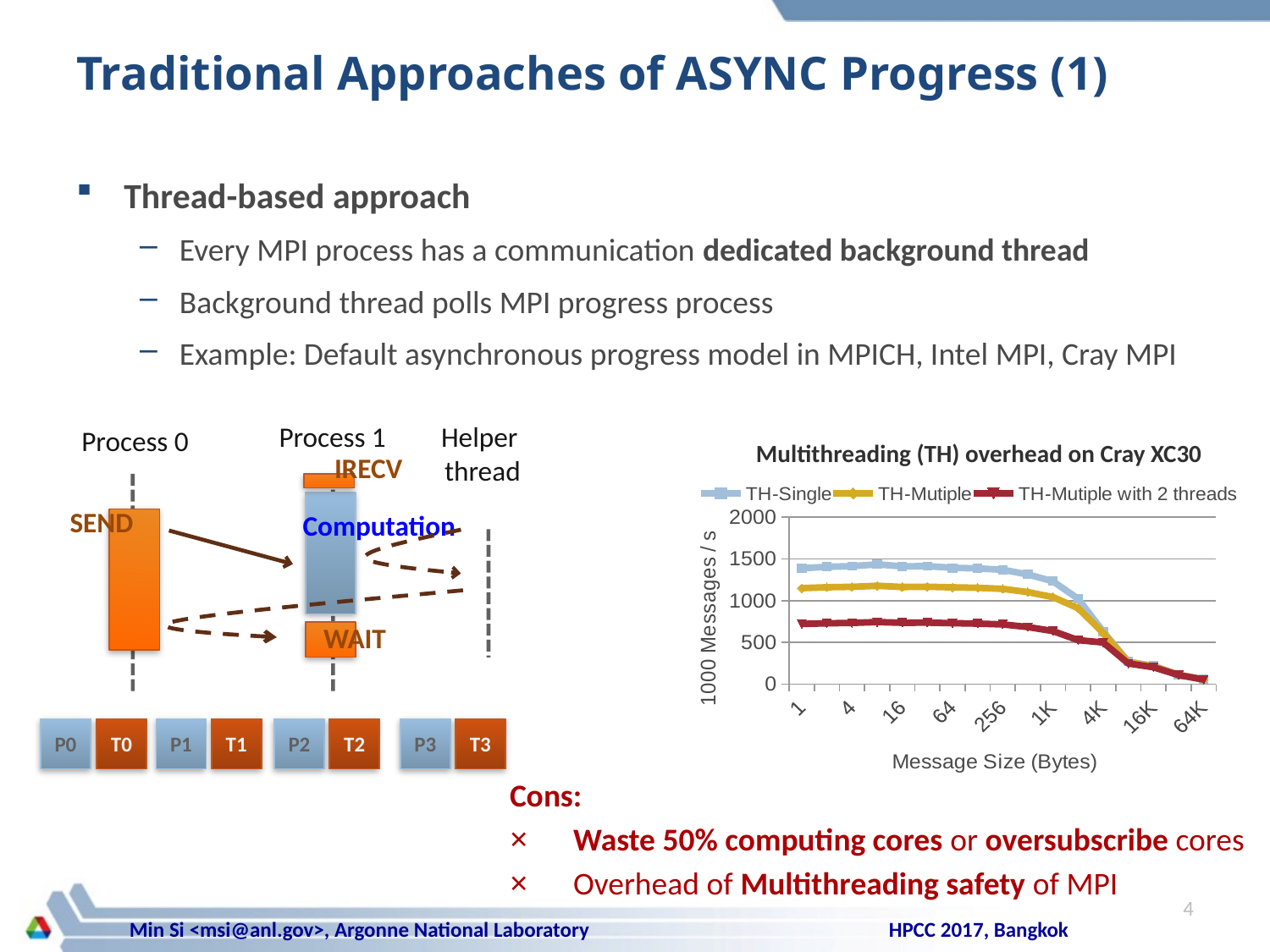
How many message-size tick labels are shown on the x axis of the chart? 9 At message size 1, which series has the larger value: TH-Single or TH-Mutiple with 2 threads? TH-Single Is the value for TH-Single at message size 64K greater or less than 500? less Do the values of the TH-Single series rise or fall as message size increases along the x axis? fall What kind of chart is shown on the slide? line chart Is the value for TH-Single at message size 1 greater or less than 1000? greater Is the value for TH-Mutiple with 2 threads at message size 1 greater or less than 500? greater What is the title of the chart? Multithreading (TH) overhead on Cray XC30 How many series does the chart's legend list? 3 What is the label of the chart's x axis? Message Size (Bytes) Which series has the lowest values at message size 16? TH-Mutiple with 2 threads